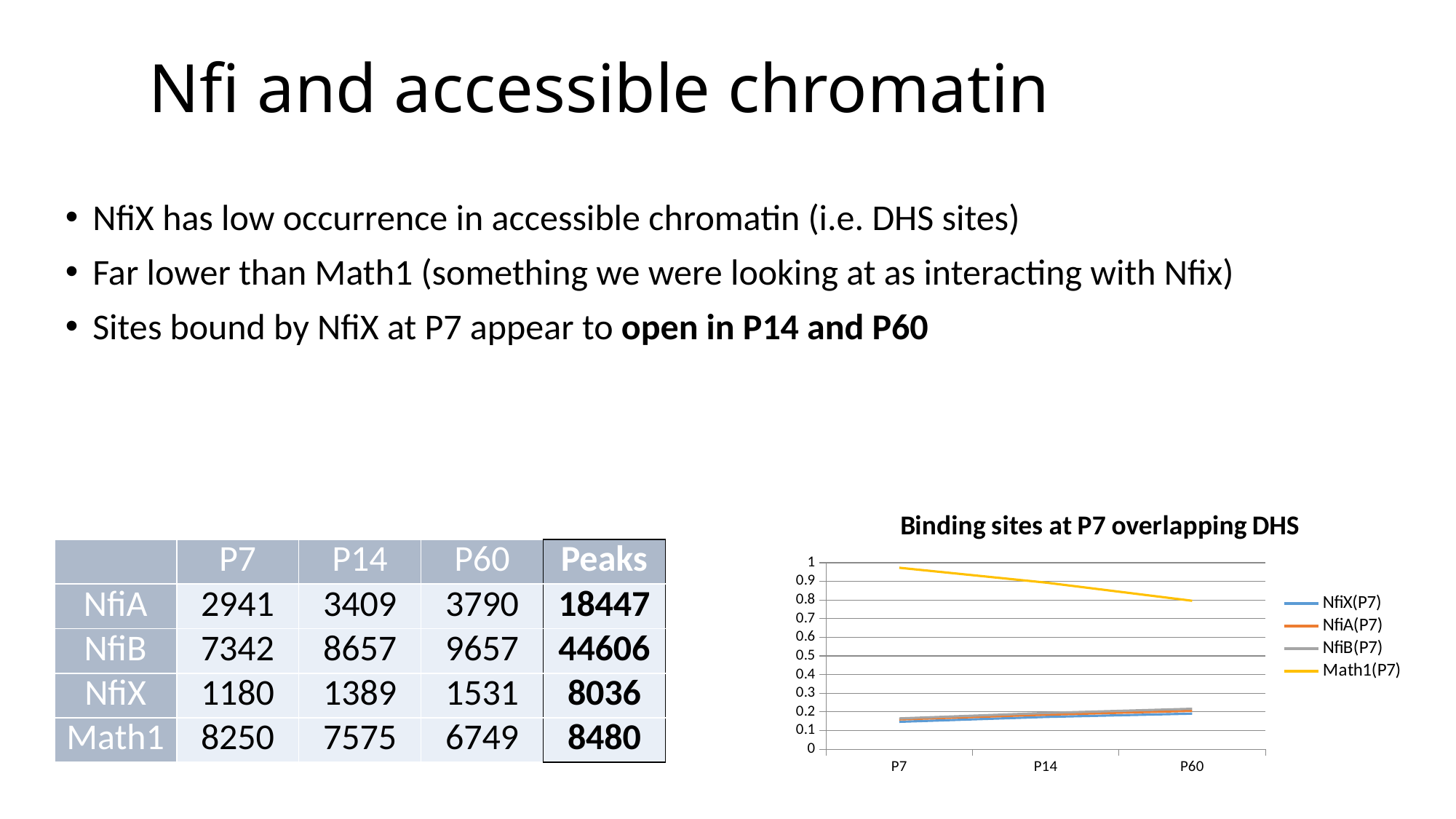
Is the value for NfiX(P7) at P7 greater or less than 0.3? less At P60, which is larger: the value for Math1(P7) or the value for NfiX(P7)? Math1(P7) What is the title of the chart? Binding sites at P7 overlapping DHS Which series is drawn in yellow in the chart? Math1(P7) Does the NfiX(P7) line rise or fall from P7 to P60? rise Which series has the highest value at P7 in the chart? Math1(P7) Is the value for Math1(P7) at P7 greater or less than 0.9? greater How many time points are shown along the x axis of the chart? 3 How many series does the chart's legend list? 4 Does the Math1(P7) line rise or fall from P7 to P60? fall What kind of chart is shown on the slide? line chart Is the value for Math1(P7) at P60 greater or less than 0.7? greater